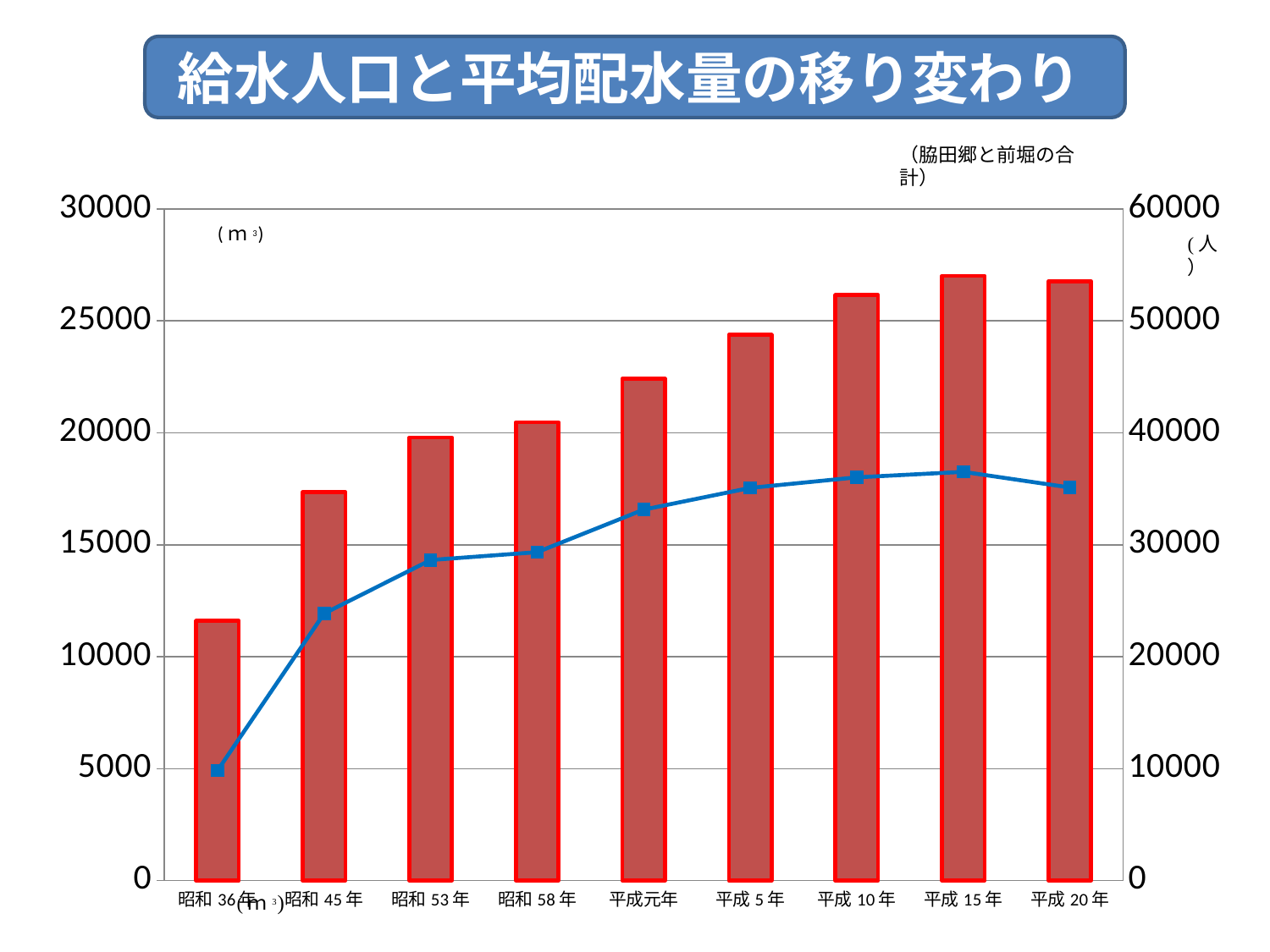
Which year has the lowest point on the blue line? 昭和36年 Is the bar for 平成元年 greater or less than 20000 on the left axis? greater Which bar is taller, 昭和36年 or 昭和45年? 昭和45年 Is the bar for 昭和36年 greater or less than 15000 on the left axis? less Do the bars generally rise or fall from 昭和36年 to 平成15年? rise Which year has the lowest bar in the chart? 昭和36年 Is the bar for 平成10年 greater or less than 25000 on the left axis? greater How many year categories are shown on the x axis of the chart? 9 What is the title of the chart on the slide? 給水人口と平均配水量の移り変わり What kind of chart is shown on the slide? A combined bar and line chart